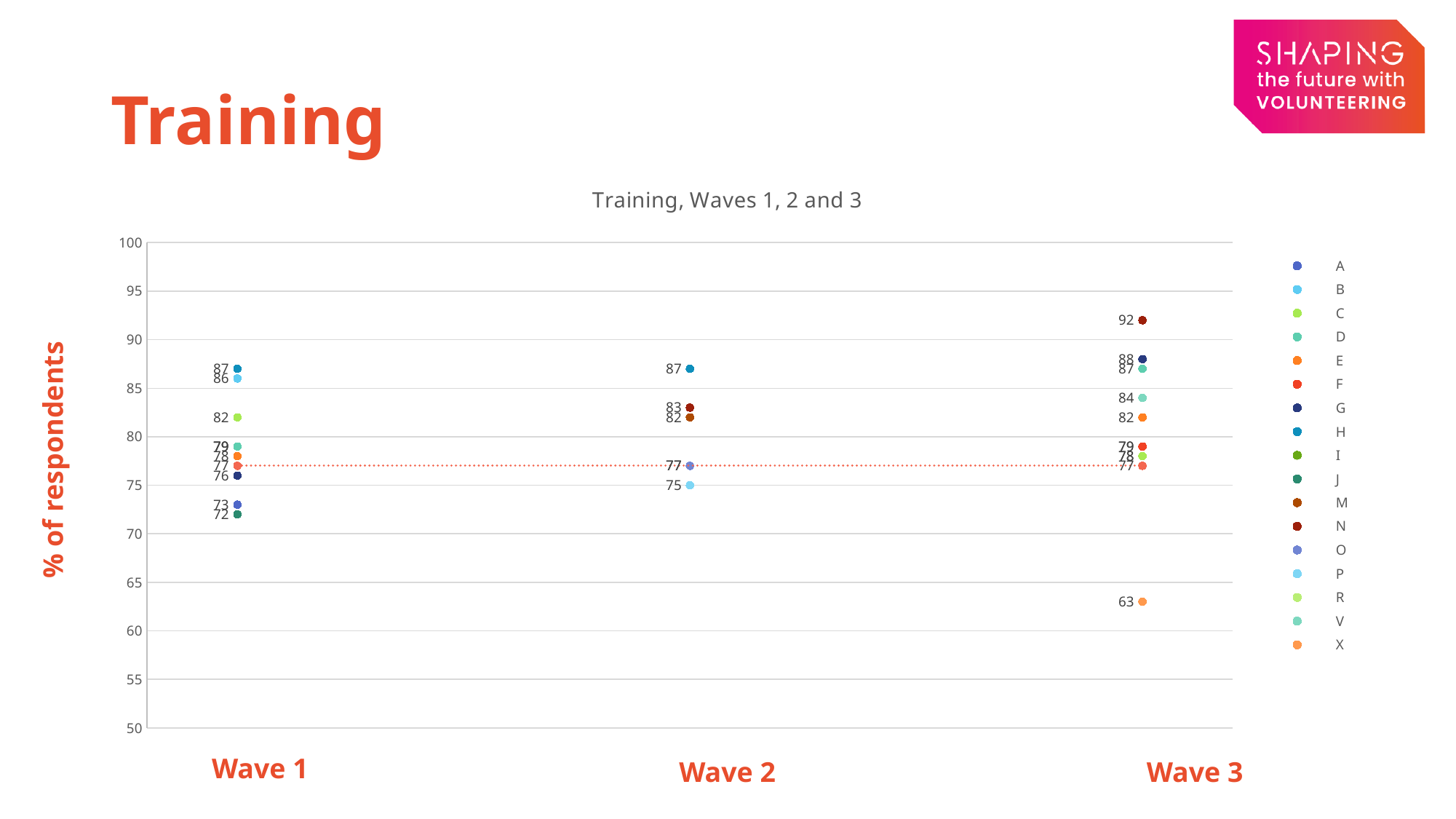
What is the difference between the highest and lowest values plotted for Wave 3? 29 What is the lowest value plotted for Wave 1? 72 How many series does the chart's legend list? 17 What is the title of the chart? Training, Waves 1, 2 and 3 What is the highest value plotted for Wave 3? 92 Is the lowest value plotted for Wave 3 greater or less than 65? less What is the lowest value plotted for Wave 3? 63 How many waves are shown along the x axis of the chart? 3 Which wave has the highest single plotted value, Wave 1 or Wave 3? Wave 3 What is the highest value plotted for Wave 1? 87 What is the label on the vertical axis of the chart? % of respondents What is the lowest value plotted for Wave 2? 75